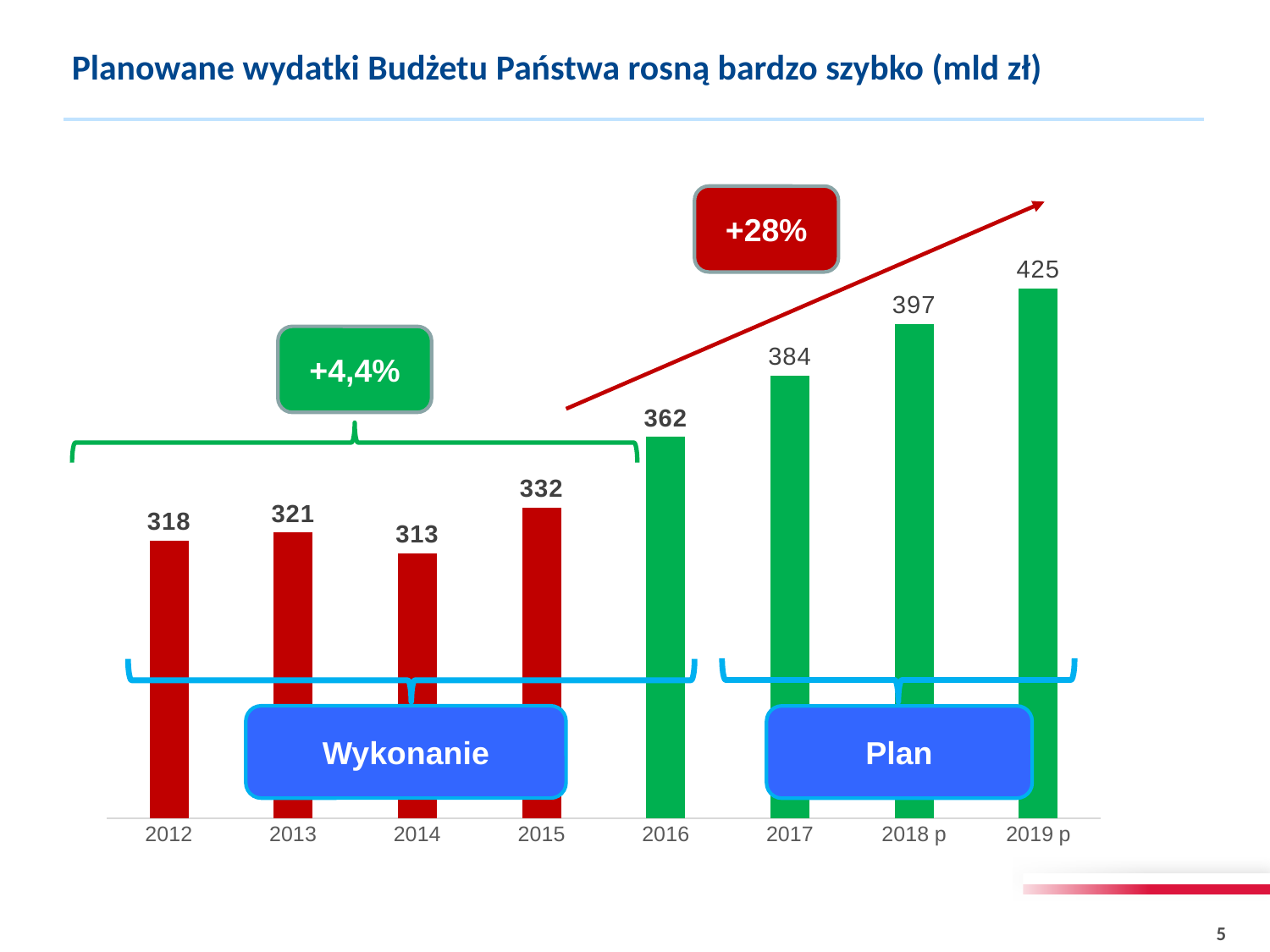
What is the difference between the values for 2019 p and 2012? 107 What is the difference between the values for 2018 p and 2017? 13 What is the value for 2019 p? 425 How many years are shown on the x axis? 8 Which year has the lowest value? 2014 Do the values generally rise or fall from 2014 to 2019 p? rise What is the value for 2012? 318 What percentage is shown in the red box above the chart? +28% Which year has the highest value? 2019 p What is the value for 2016? 362 What kind of chart is this? bar chart Which is larger, the value for 2013 or the value for 2015? 2015